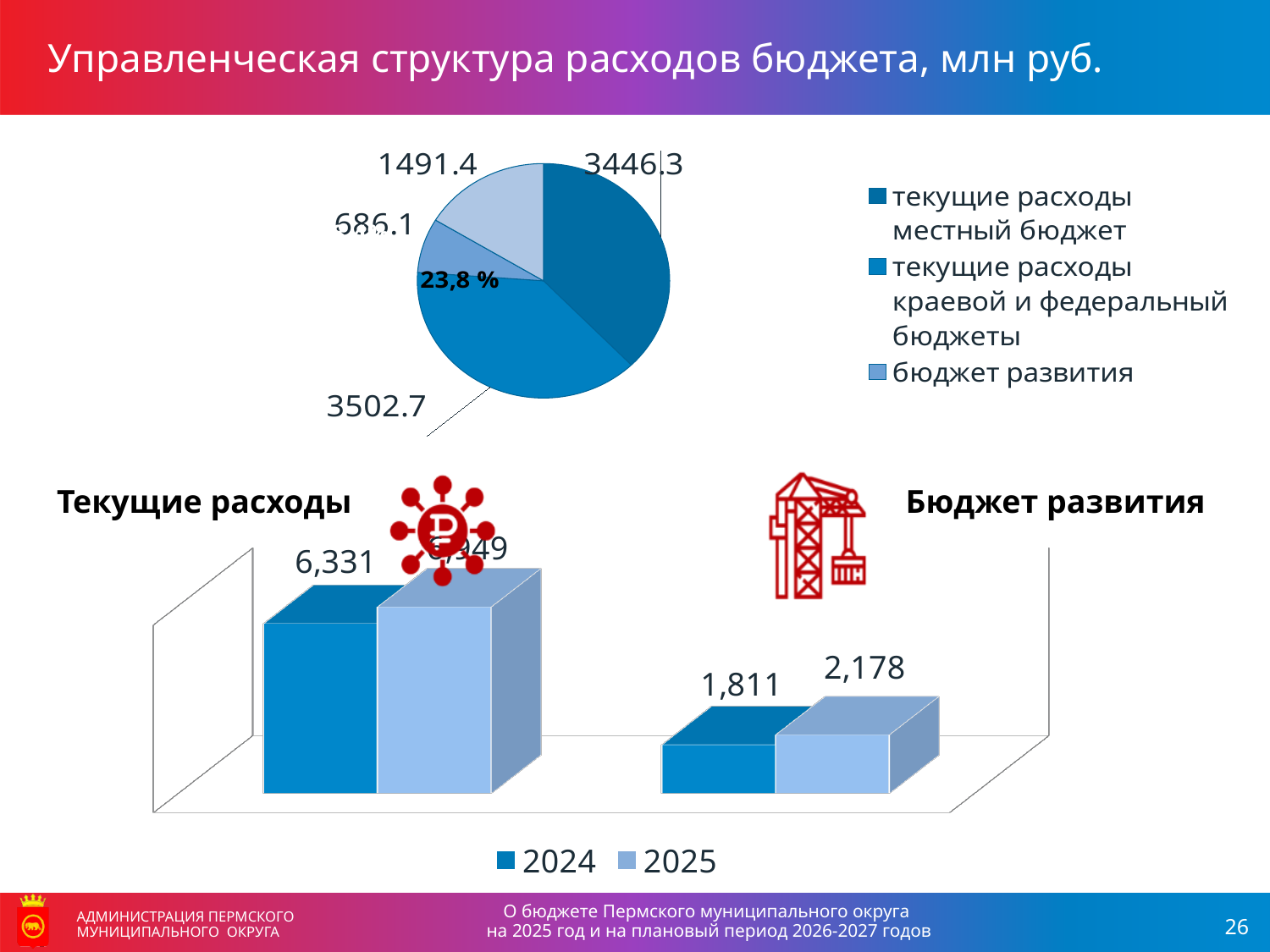
In the bottom bar chart, what is the 2024 value for Бюджет развития? 1,811 How many series does the legend of the bottom bar chart list? 2 In the pie chart, what is the value for текущие расходы краевой и федеральный бюджеты? 3502.7 In the bottom bar chart, which year has the larger value for Бюджет развития, 2024 or 2025? 2025 In the bottom bar chart, what is the difference between the 2025 and 2024 values for Бюджет развития? 367 In the bottom bar chart, what is the 2025 value for Бюджет развития? 2,178 In the pie chart, what is the difference between the values for текущие расходы краевой и федеральный бюджеты and текущие расходы местный бюджет? 56.4 What kind of chart is the top chart on the slide? pie chart In the pie chart, what is the value for текущие расходы местный бюджет? 3446.3 In the bottom bar chart, what is the 2024 value for Текущие расходы? 6,331 How many entries does the legend of the pie chart list? 3 In the pie chart, what is the value for бюджет развития? 686.1